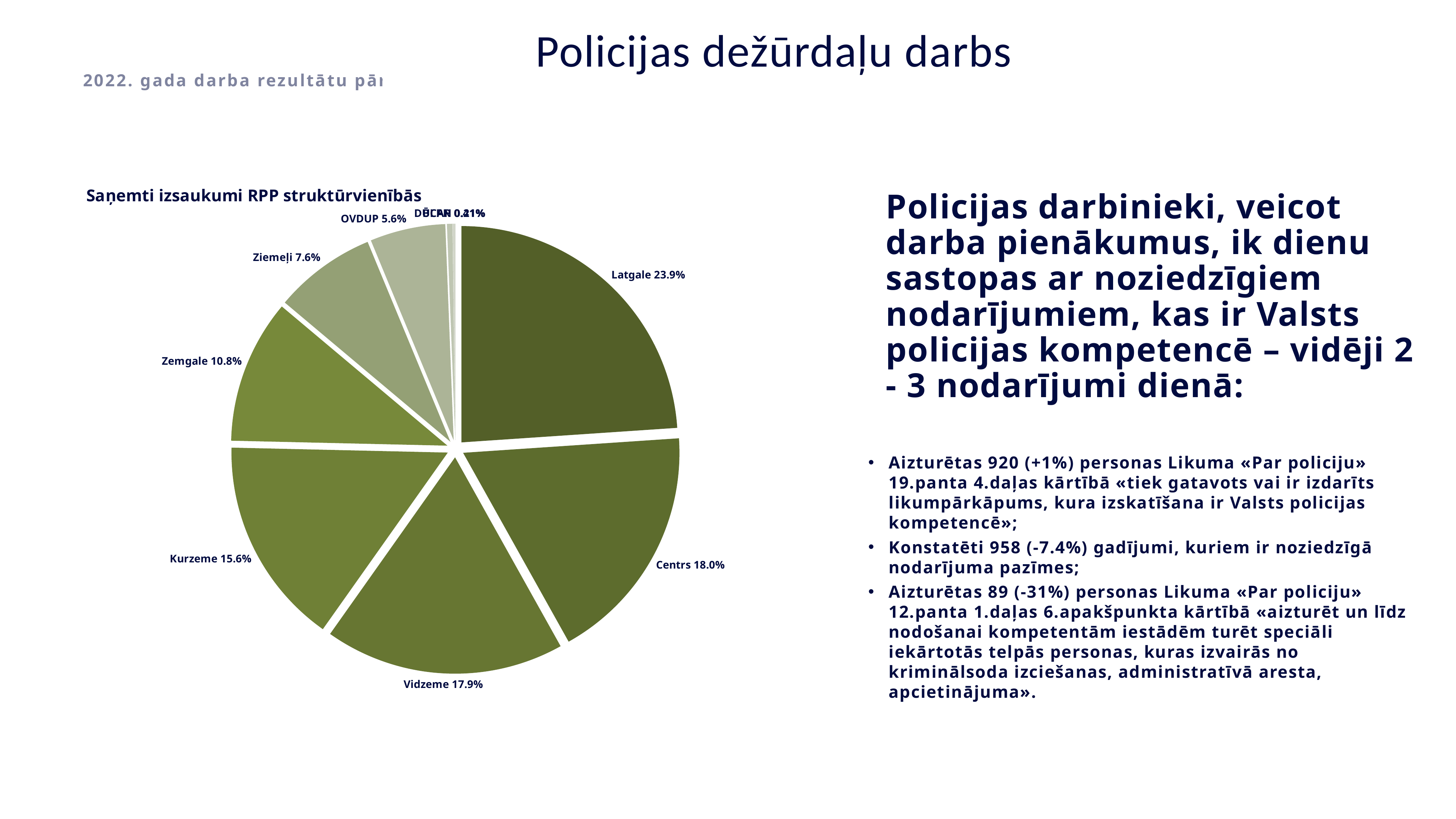
What is the value shown for Zemgale? 10.8% What is the value shown for Vidzeme? 17.9% Which is larger, the slice for Kurzeme or the slice for Zemgale? Kurzeme What is the value shown for Ziemeļi? 7.6% What is the title of the pie chart? Saņemti izsaukumi RPP struktūrvienībās What share of the pie does Latgale have? 23.9% Which slice of the pie is the largest? Latgale What is the value shown for OVDUP? 5.6% What is the difference between the Latgale and Centrs shares? 5.9% What is the value shown for Kurzeme? 15.6% What is the value shown for Centrs? 18.0% What kind of chart is shown on the slide? pie chart